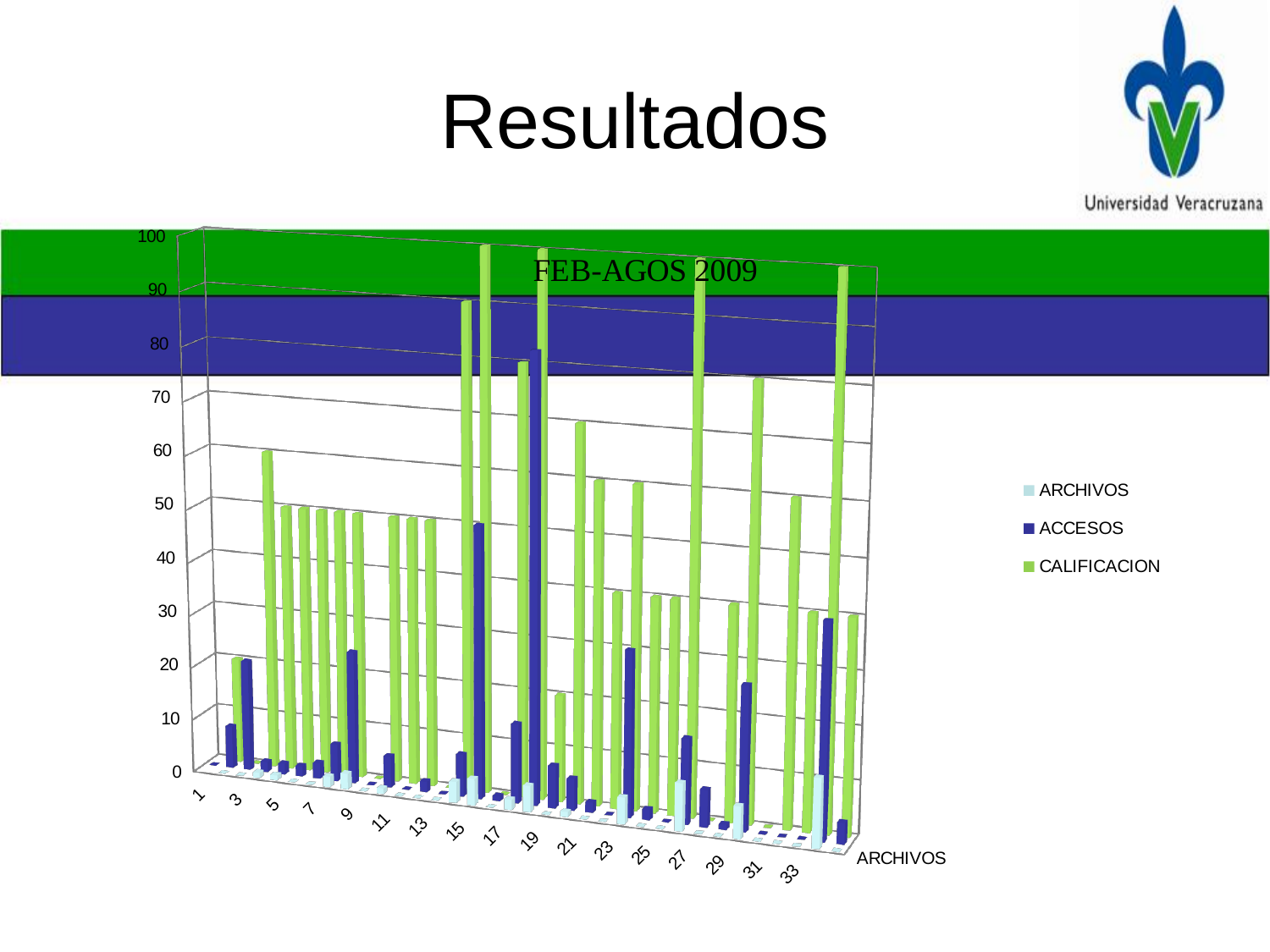
Is the tallest ARCHIVOS bar in the chart greater or less than 20? less What are the three series named in the chart legend? ARCHIVOS, ACCESOS, CALIFICACION Is the tallest CALIFICACION bar in the chart greater or less than 90? greater What is the highest value shown on the vertical axis of the chart? 100 Which series has the shortest bars overall in the chart? ARCHIVOS Which series is drawn in green in the chart? CALIFICACION What kind of chart is shown on the slide? bar chart Which series has the tallest bars overall in the chart, CALIFICACION or ARCHIVOS? CALIFICACION How many series does the chart legend list? 3